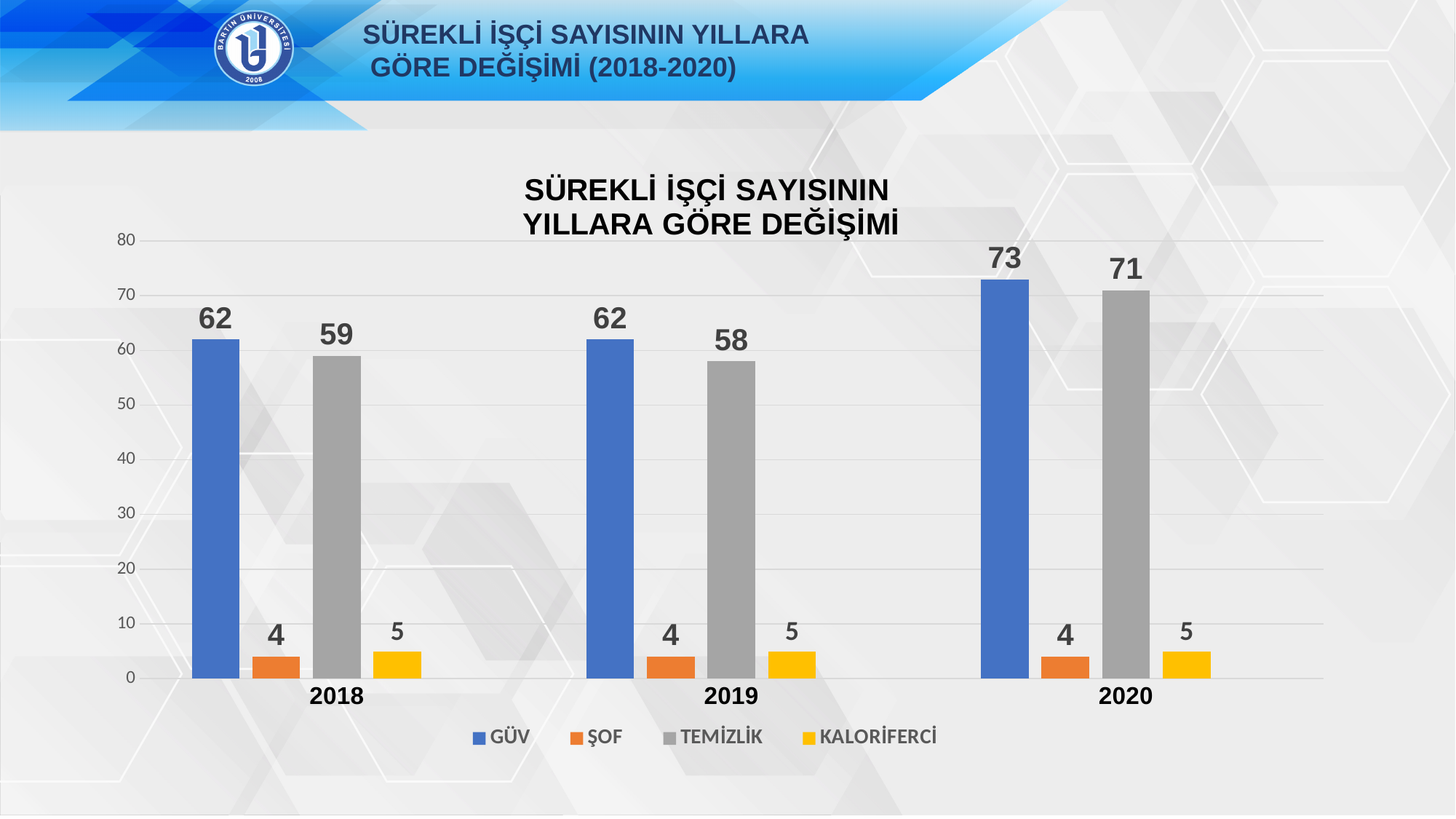
In which year is the GÜV value highest? 2020 What is the value for ŞOF in 2019? 4 Which series has the lowest value in 2018? ŞOF Which is larger in 2019, GÜV or TEMİZLİK? GÜV How many years are shown on the x axis? 3 What is the value for GÜV in 2020? 73 What is the value for TEMİZLİK in 2018? 59 Does the TEMİZLİK value rise or fall from 2019 to 2020? Rise What kind of chart is shown on the slide? Bar chart What is the value for KALORİFERCİ in 2020? 5 What is the difference between the TEMİZLİK values in 2020 and 2019? 13 How many series does the legend list? 4